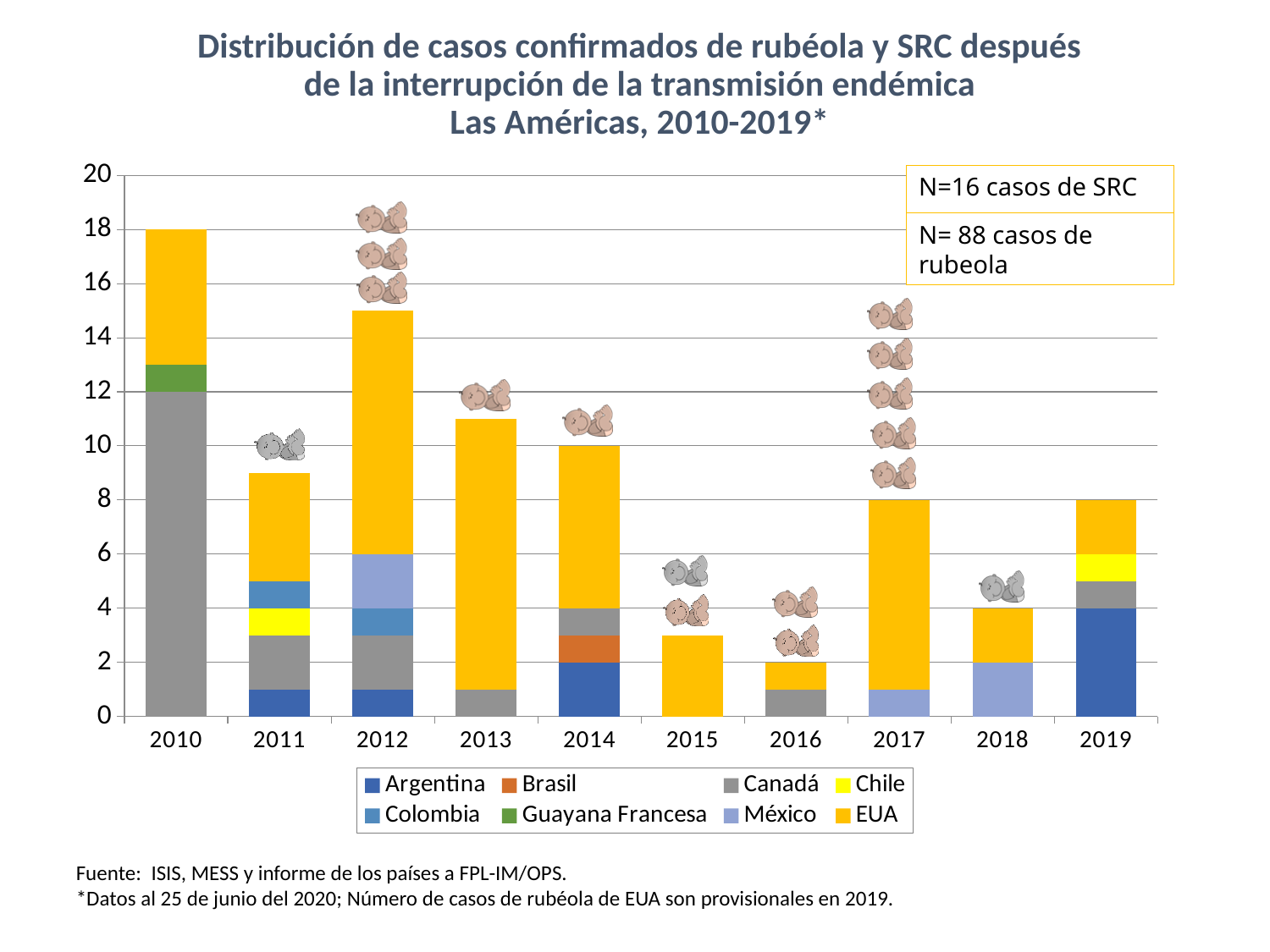
What is the value for Canadá in 2010? 12 Which year has a taller stacked bar, 2014 or 2018? 2014 What is the value for Argentina in 2019? 4 Which year has the shortest stacked bar? 2016 Which year has the tallest stacked bar? 2010 How many countries does the legend list? 8 What is the total height of the stacked bar for 2010? 18 What is the total height of the stacked bar for 2016? 2 What kind of chart is shown on the slide? Stacked bar chart Is the total for 2015 greater or less than 4? less How many years are shown on the x axis of the chart? 10 Is the total for 2012 greater or less than 14? greater